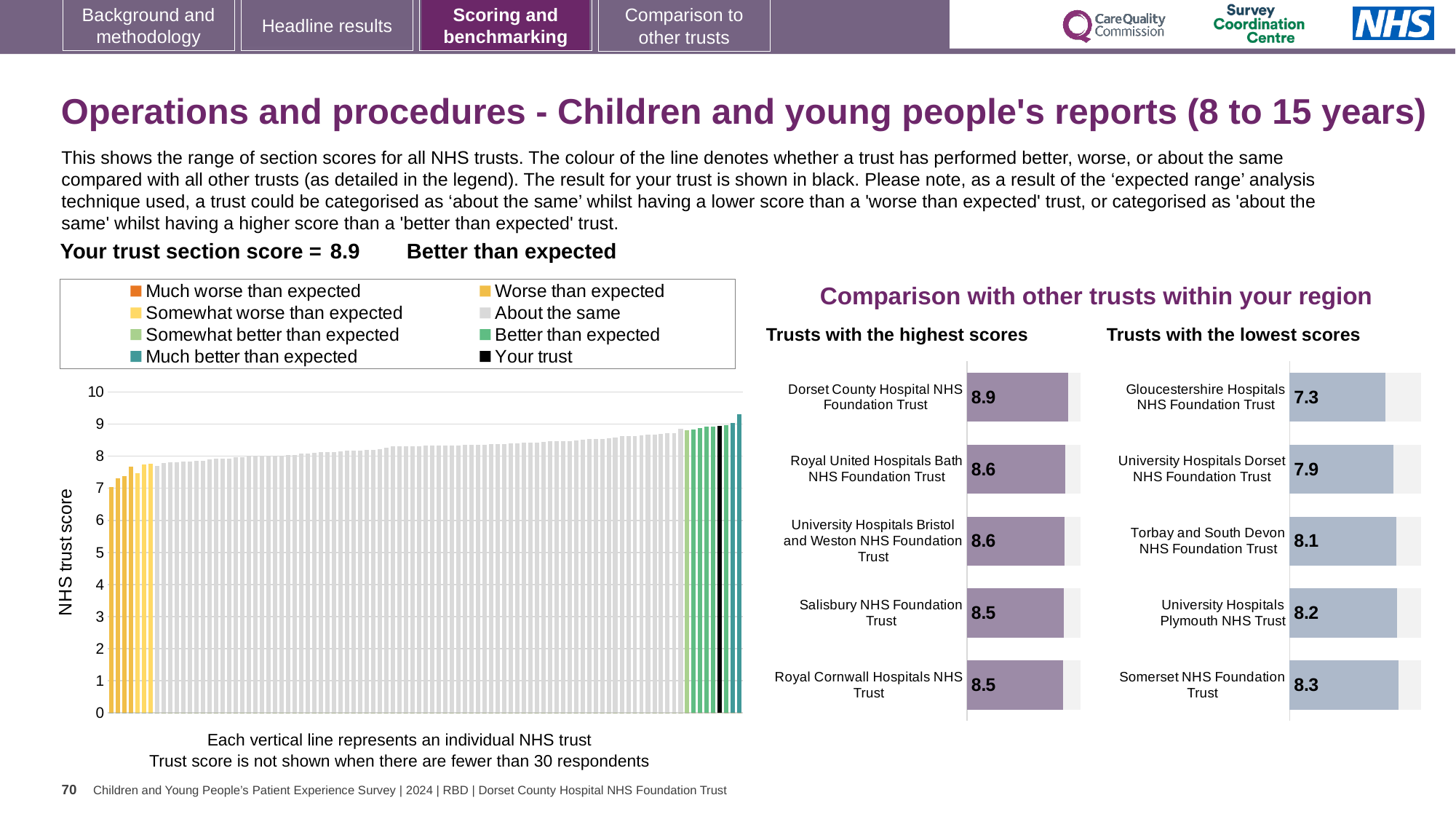
In the 'Trusts with the lowest scores' chart, what is the score for Gloucestershire Hospitals NHS Foundation Trust? 7.3 In the 'Trusts with the highest scores' chart, which trust has the highest score? Dorset County Hospital NHS Foundation Trust In the 'Trusts with the lowest scores' chart, what is the difference between the scores of Somerset NHS Foundation Trust and Gloucestershire Hospitals NHS Foundation Trust? 1.0 In the 'Trusts with the highest scores' chart, what is the score for Salisbury NHS Foundation Trust? 8.5 In the 'Trusts with the lowest scores' chart, which has the higher score: Torbay and South Devon NHS Foundation Trust or Somerset NHS Foundation Trust? Somerset NHS Foundation Trust In the 'Trusts with the highest scores' chart, what is the difference between the scores of Dorset County Hospital NHS Foundation Trust and Royal Cornwall Hospitals NHS Trust? 0.4 In the 'Trusts with the highest scores' chart, what is the score for Dorset County Hospital NHS Foundation Trust? 8.9 In the 'Trusts with the lowest scores' chart, which trust has the lowest score? Gloucestershire Hospitals NHS Foundation Trust How many entries does the legend of the large 'NHS trust score' chart on the left list? 8 How many trusts are shown in the 'Trusts with the highest scores' chart? 5 In the 'Trusts with the lowest scores' chart, what is the score for University Hospitals Plymouth NHS Trust? 8.2 In the large 'NHS trust score' chart on the left, is the value for the black 'Your trust' bar greater or less than 8? greater